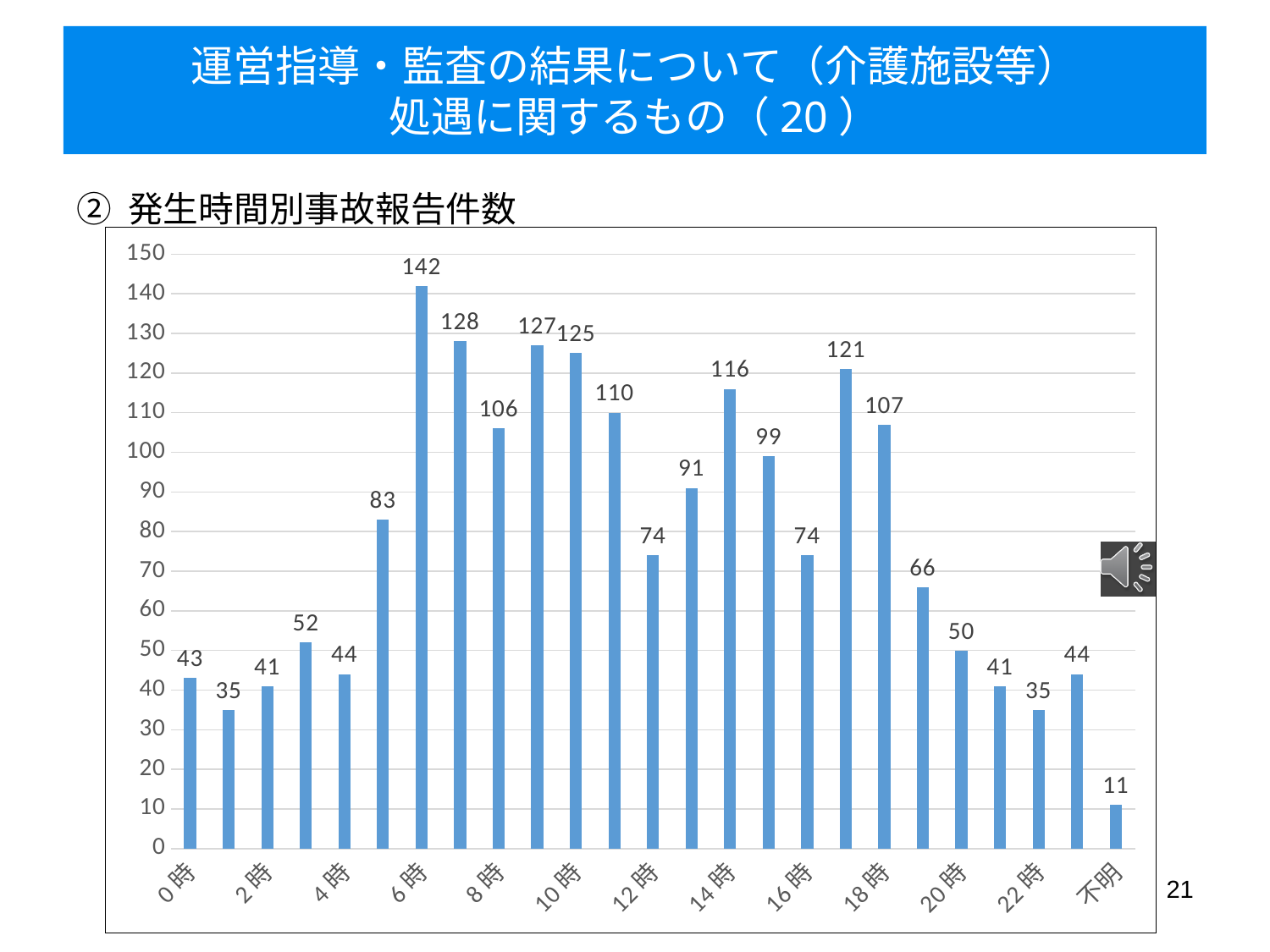
What kind of chart is shown on the slide? bar chart Which is larger, the value for 10時 or the value for 14時? 10時 What is the difference between the values for 20時 and 22時? 15 Which category has the highest value? 6時 How many bars are plotted in the chart? 25 Is the value for 4時 greater or less than 50? less What is the value for 18時? 107 What is the difference between the values for 6時 and 8時? 36 What is the value for 0時? 43 What is the value for 不明? 11 What is the value for 6時? 142 Which category has the lowest value? 不明